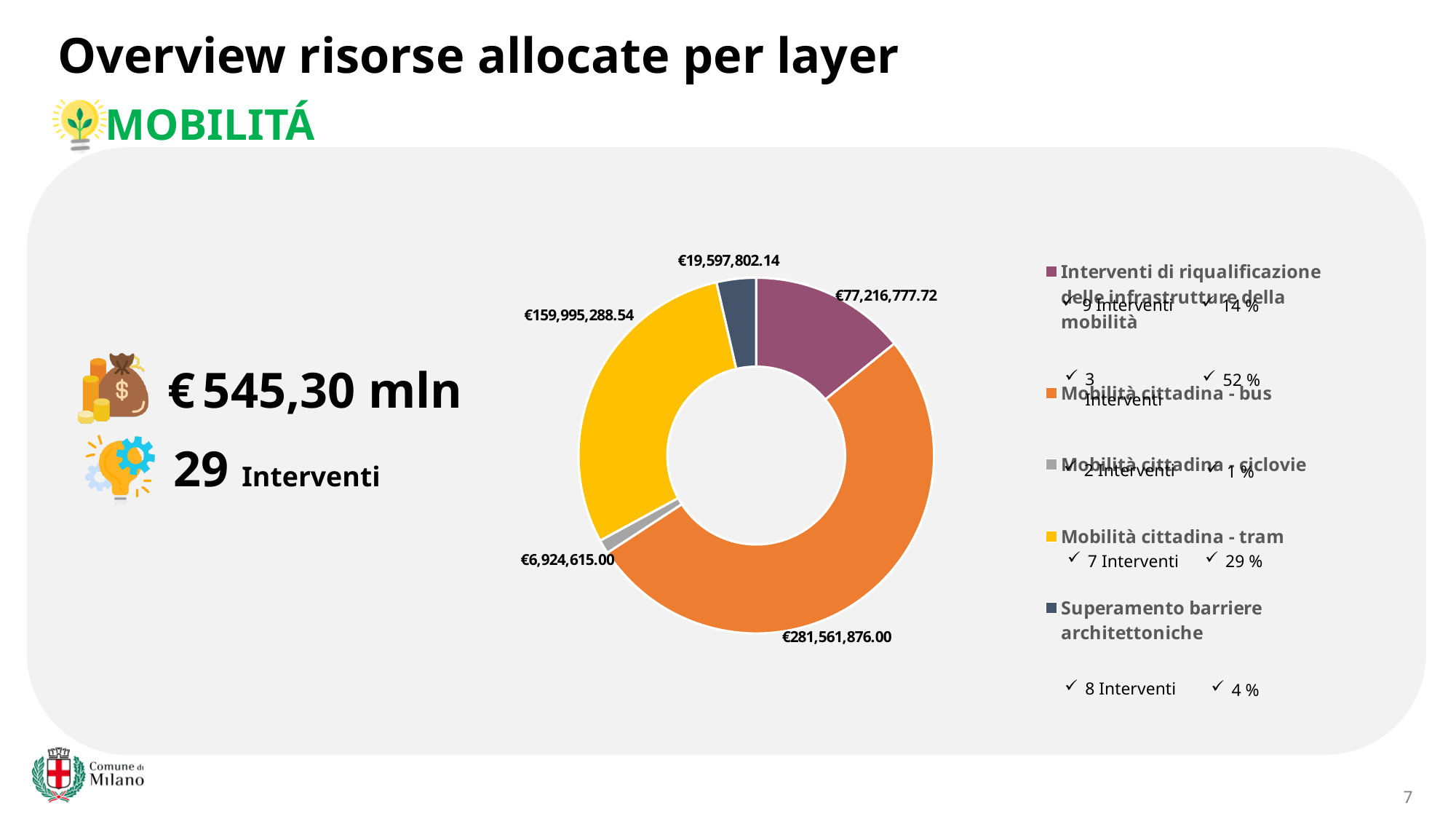
What colour is the slice for Mobilità cittadina - tram? Yellow What is the difference between the values for Mobilità cittadina - bus and Mobilità cittadina - tram? €121,566,587.46 How many categories does the chart show? 5 What is the value for Mobilità cittadina - tram? €159,995,288.54 Which category has the largest slice of the chart? Mobilità cittadina - bus Which category has the smallest slice of the chart? Mobilità cittadina - ciclovie What type of chart is shown on the slide? Doughnut (pie) chart What is the value for Superamento barriere architettoniche? €19,597,802.14 What is the value for Interventi di riqualificazione delle infrastrutture della mobilità? €77,216,777.72 What is the value for Mobilità cittadina - bus? €281,561,876.00 What share of the total does Mobilità cittadina - bus represent, according to the slide? 52 % Which is larger, the value for Interventi di riqualificazione delle infrastrutture della mobilità or the value for Superamento barriere architettoniche? Interventi di riqualificazione delle infrastrutture della mobilità